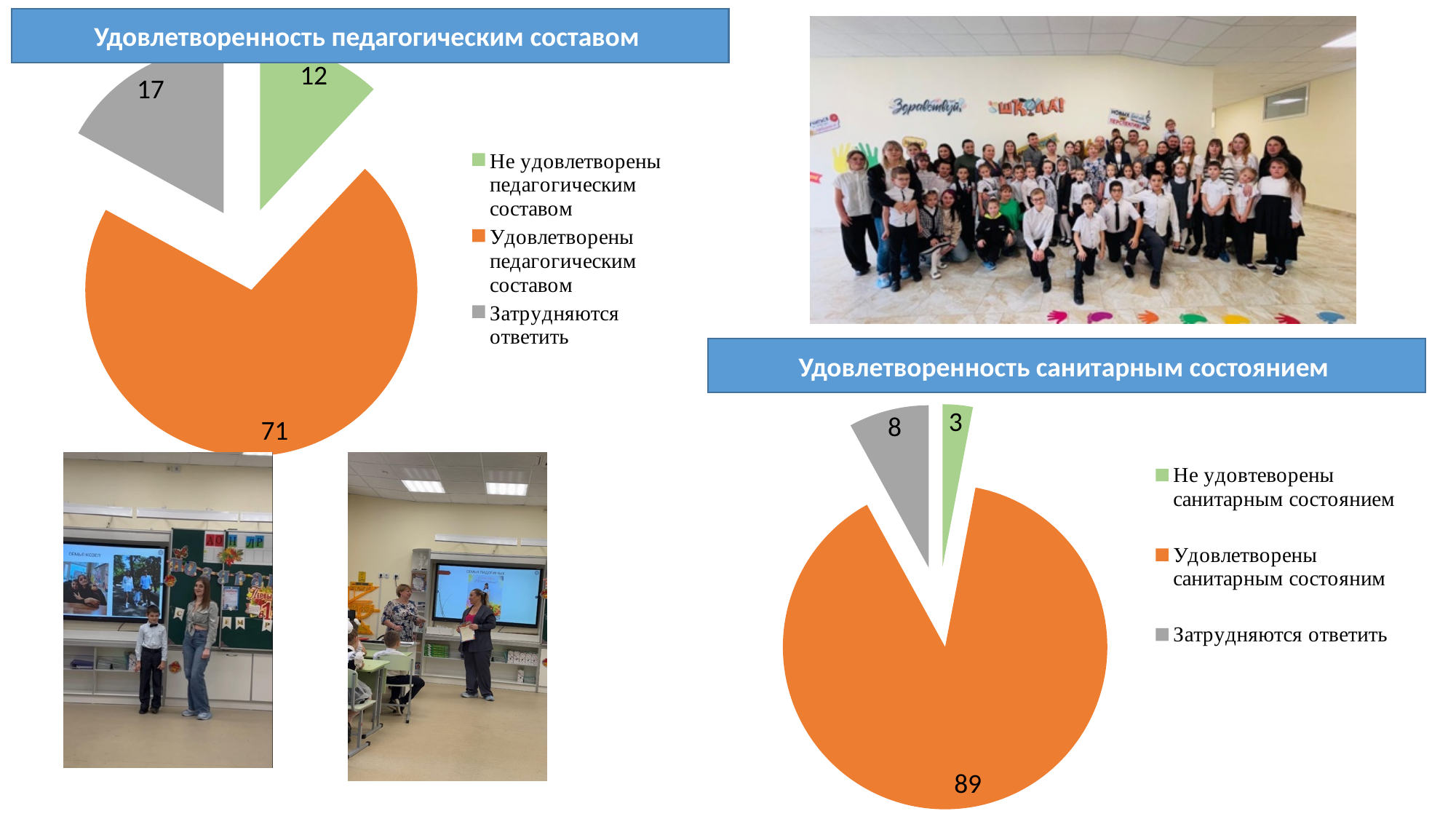
In the chart titled "Удовлетворенность педагогическим составом", what is the difference between the values for "Удовлетворены педагогическим составом" and "Затрудняются ответить"? 54 In the chart titled "Удовлетворенность санитарным состоянием", what is the value for "Удовлетворены санитарным состояним"? 89 In the chart titled "Удовлетворенность санитарным состоянием", what is the difference between the values for "Затрудняются ответить" and "Не удовтеворены санитарным состоянием"? 5 In the chart titled "Удовлетворенность педагогическим составом", what is the value for "Удовлетворены педагогическим составом"? 71 How many slices does the chart titled "Удовлетворенность санитарным состоянием" have? 3 In the chart titled "Удовлетворенность педагогическим составом", what is the value for "Затрудняются ответить"? 17 What type of chart is the chart titled "Удовлетворенность педагогическим составом"? Pie chart In the chart titled "Удовлетворенность педагогическим составом", which is larger: the value for "Не удовлетворены педагогическим составом" or the value for "Затрудняются ответить"? Затрудняются ответить In the chart titled "Удовлетворенность педагогическим составом", which category has the smallest slice? Не удовлетворены педагогическим составом In the chart titled "Удовлетворенность санитарным состоянием", which category has the largest slice? Удовлетворены санитарным состояним In the chart titled "Удовлетворенность санитарным состоянием", what is the value for "Не удовтеворены санитарным состоянием"? 3 In the chart titled "Удовлетворенность санитарным состоянием", what colour is the slice for "Затрудняются ответить"? Grey